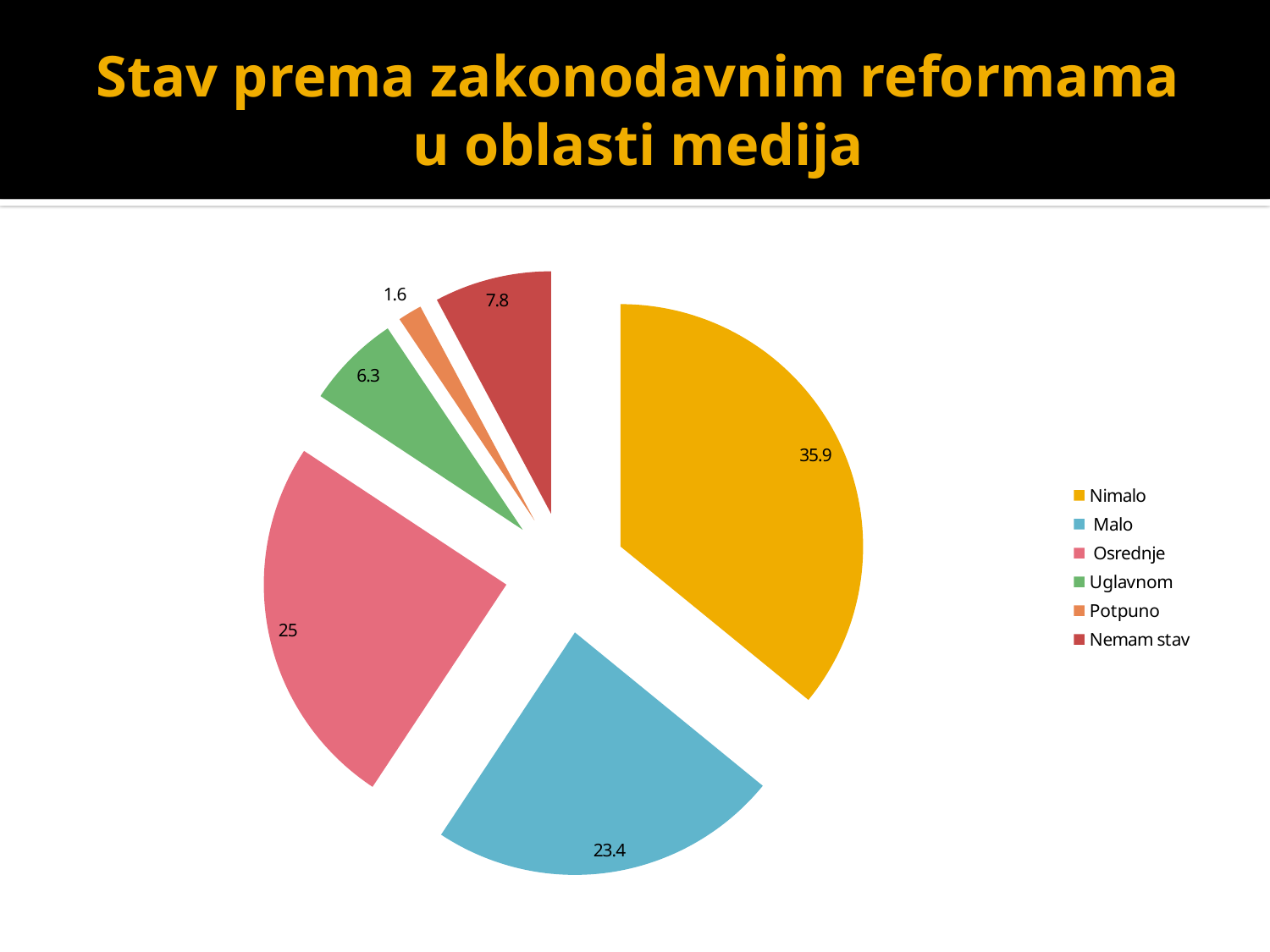
What is the value for Osrednje? 25 What is the value for Nimalo? 35.9 How many categories does the legend list? 6 Which category has the largest slice? Nimalo Which category has the smallest slice? Potpuno What kind of chart is shown on the slide? pie chart What is the difference between the values for Nimalo and Malo? 12.5 Which is larger, the value for Osrednje or the value for Malo? Osrednje What is the value for Malo? 23.4 What is the value for Uglavnom? 6.3 What is the value for Potpuno? 1.6 What is the value for Nemam stav? 7.8